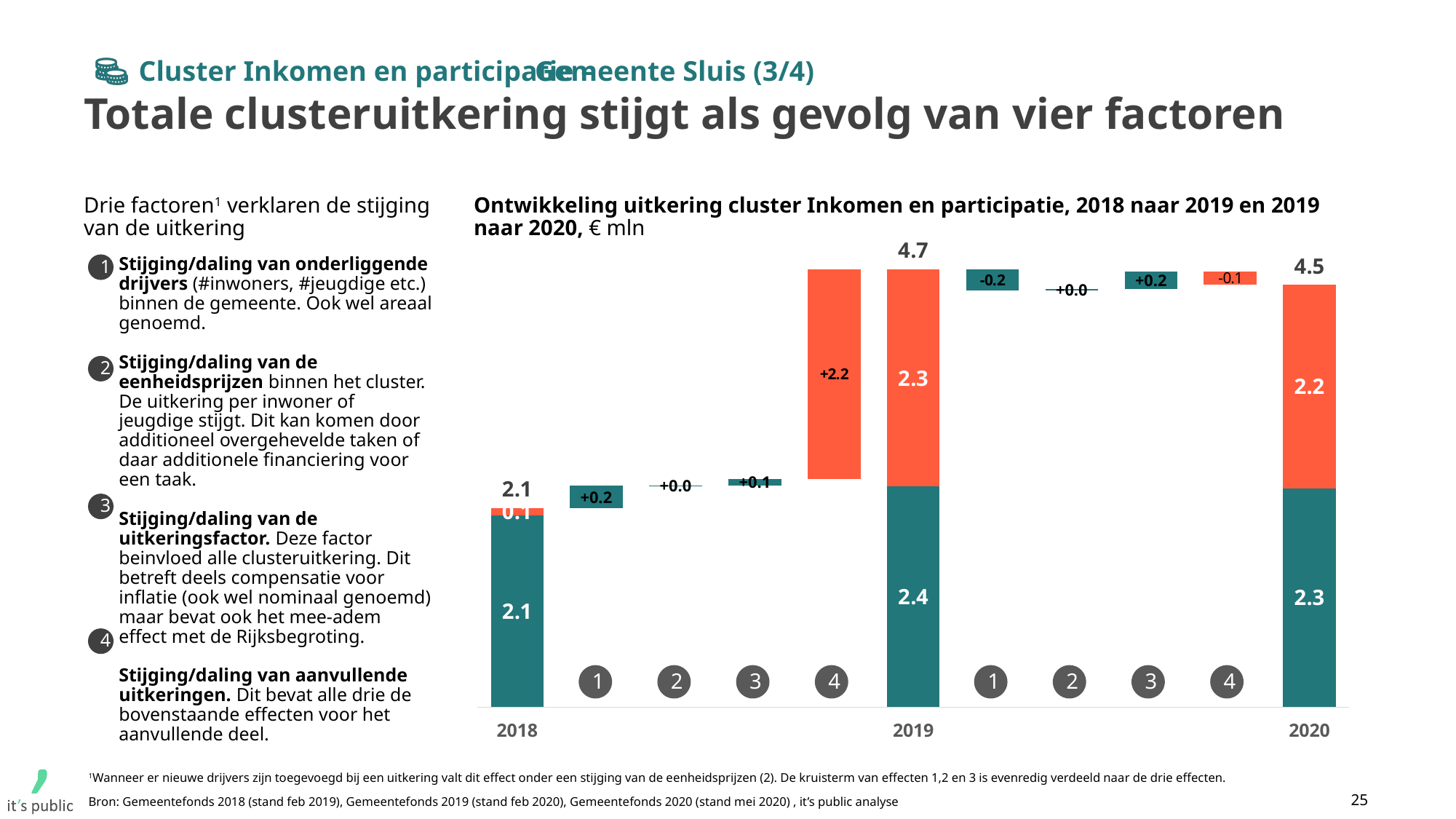
What is the total value shown for 2019? 4.7 What is the difference between the 2019 total and the 2018 total? 2.6 What is the value of the orange (upper) segment of the 2020 bar? 2.2 What is the value of step 3 between 2019 and 2020? +0.2 Which year has the lowest total value? 2018 What is the total value shown for 2020? 4.5 Which year has the highest total value? 2019 What is the value of step 1 between 2019 and 2020? -0.2 What is the total value shown for 2018? 2.1 What unit is stated in the chart title? € mln What is the value of the teal (lower) segment of the 2019 bar? 2.4 What is the value of step 4 between 2018 and 2019? +2.2